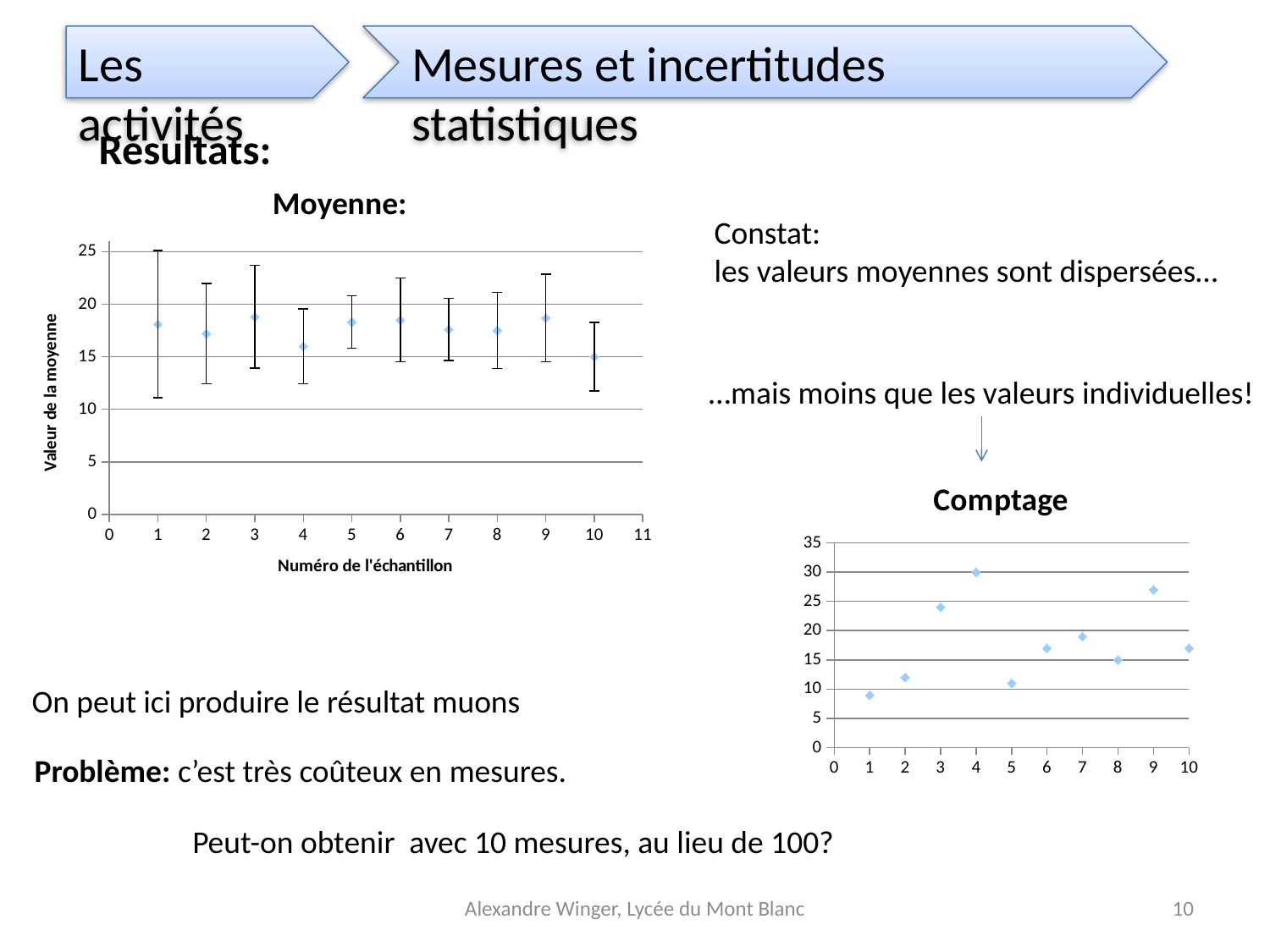
How many data points are plotted in the 'Moyenne:' chart? 10 In the 'Moyenne:' chart, which sample number has the lowest mean value? 10 In the 'Comptage' chart, which x value has the highest count? 4 In the 'Comptage' chart, what is the count at x = 4? 30 In the 'Comptage' chart, which x value has the lowest count? 1 What kind of chart is the 'Moyenne:' chart on the left? scatter chart In the 'Comptage' chart, which has the larger count, x = 9 or x = 6? 9 In the 'Moyenne:' chart, is the mean value for sample 1 greater or less than 15? greater In the 'Comptage' chart, is the count at x = 3 greater or less than 20? greater In the 'Comptage' chart, what is the count at x = 8? 15 In the 'Moyenne:' chart, what is the title of the x axis? Numéro de l'échantillon In the 'Moyenne:' chart, what is the title of the y axis? Valeur de la moyenne